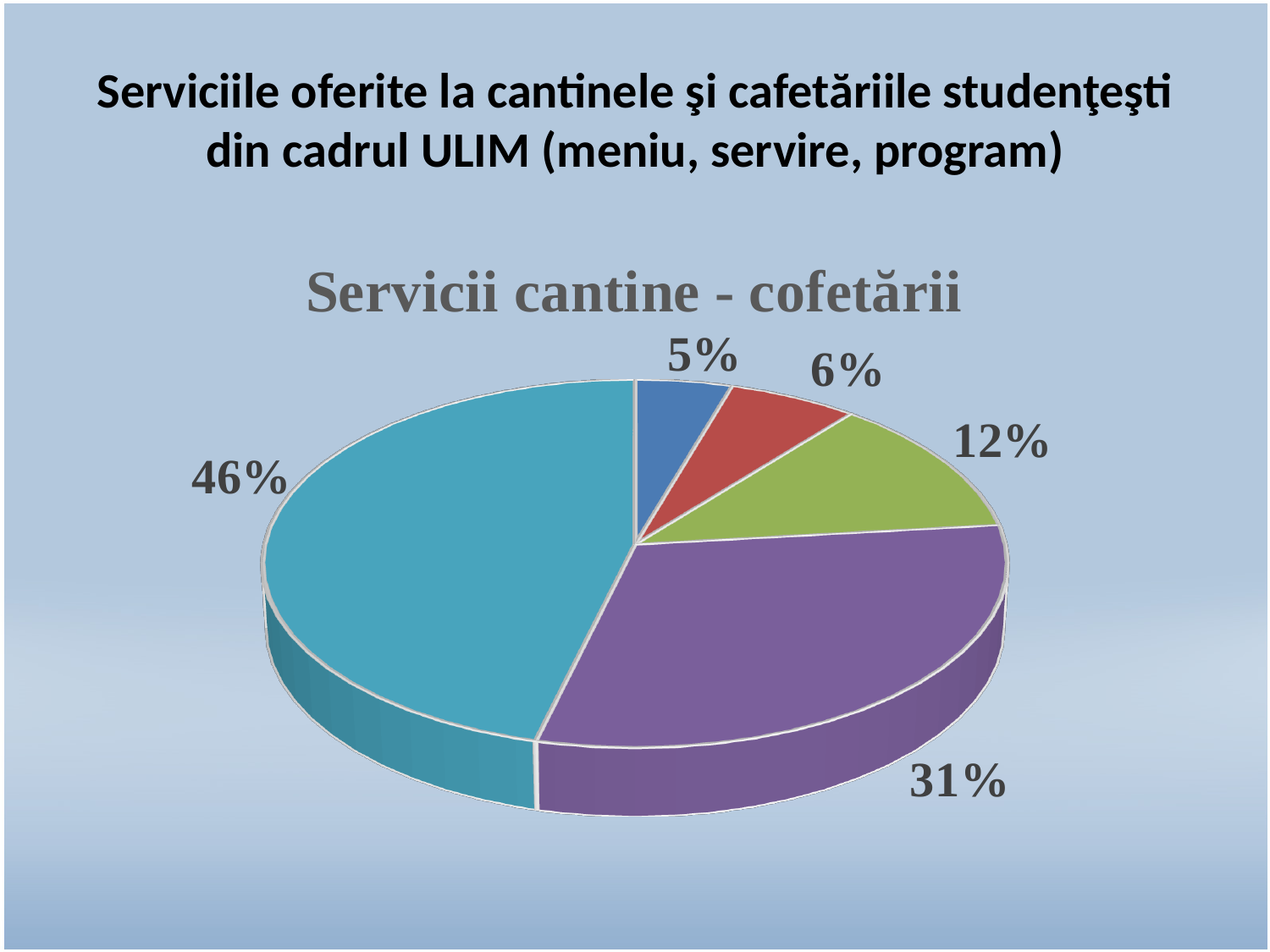
What kind of chart is shown on the slide? pie chart What is the largest share shown in the pie chart? 46% What colour is the largest slice of the pie chart? teal (light blue) What share does the dark blue slice of the pie chart represent? 5% How many slices does the pie chart have? 5 What share does the purple slice of the pie chart represent? 31% What is the difference in percentage points between the largest slice (46%) and the second largest slice (31%)? 15 What is the title of the pie chart? Servicii cantine - cofetării What share does the red slice of the pie chart represent? 6% Which slice is larger, the green slice or the red slice? the green slice What is the smallest share shown in the pie chart? 5%